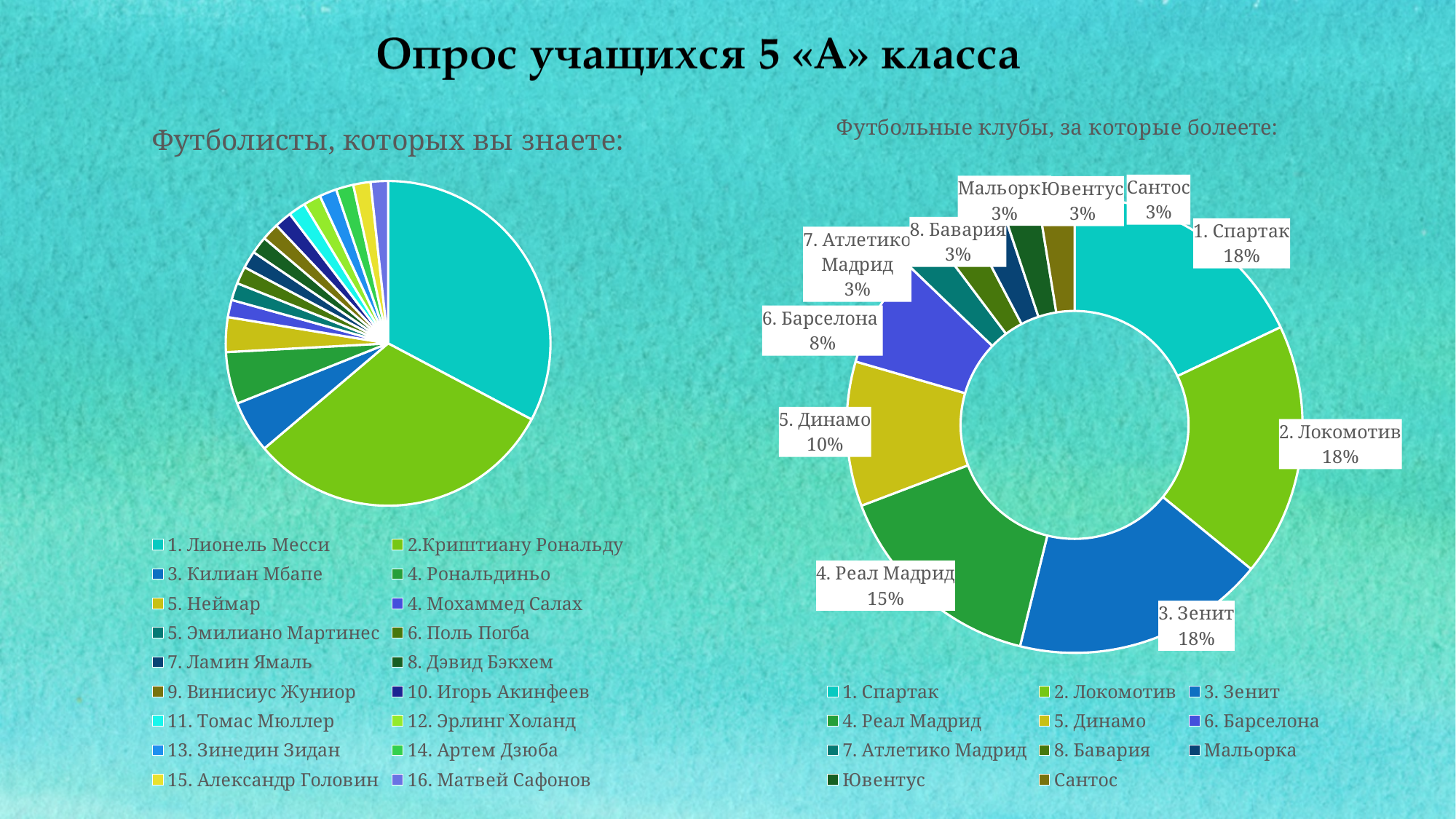
On the chart 'Футбольные клубы, за которые болеете:', what share of the responses is for 1. Спартак? 18% On the chart 'Футбольные клубы, за которые болеете:', how many clubs are listed in the legend? 11 On the chart 'Футбольные клубы, за которые болеете:', which has the larger share: 5. Динамо or 6. Барселона? 5. Динамо On the chart 'Футбольные клубы, за которые болеете:', what percentage is shown for 4. Реал Мадрид? 15% On the chart 'Футбольные клубы, за которые болеете:', what percentage is shown for 5. Динамо? 10% What is the title of the slide? Опрос учащихся 5 «А» класса On the chart 'Футболисты, которых вы знаете:', which slice is larger: 1. Лионель Месси or 5. Неймар? 1. Лионель Месси On the chart 'Футбольные клубы, за которые болеете:', what is the difference in percentage points between 4. Реал Мадрид and 5. Динамо? 5% What kind of chart is 'Футболисты, которых вы знаете:'? Pie chart On the chart 'Футболисты, которых вы знаете:', how many footballers are listed in the legend? 18 On the chart 'Футбольные клубы, за которые болеете:', what percentage is shown for 8. Бавария? 3% On the chart 'Футбольные клубы, за которые болеете:', what percentage is shown for 6. Барселона? 8%